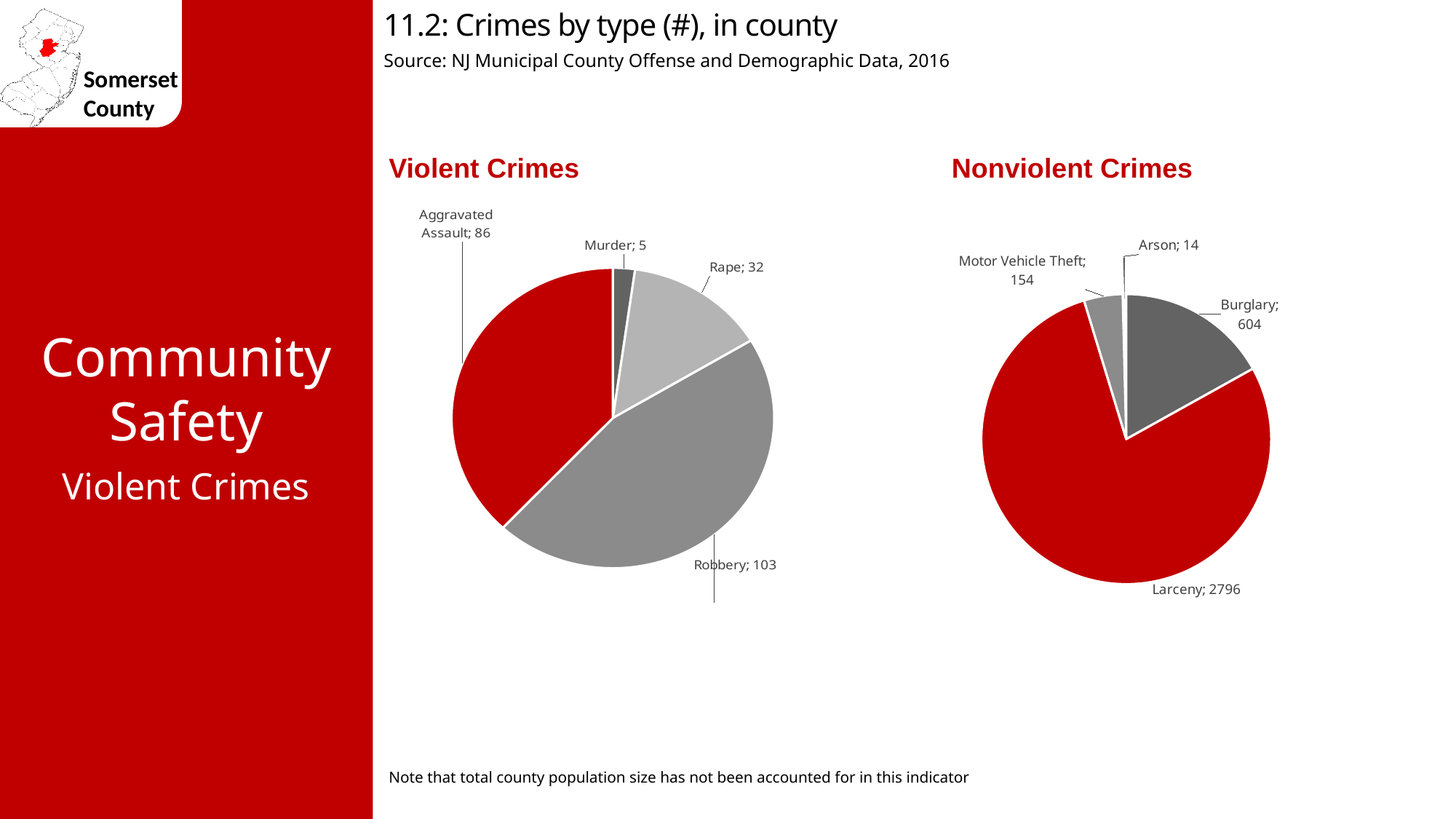
In the Nonviolent Crimes chart, what is the value for Motor Vehicle Theft? 154 In the Nonviolent Crimes chart, what share of the total does Larceny represent, to the nearest whole percent? 78% In the Nonviolent Crimes chart, what is the value for Burglary? 604 In the Violent Crimes chart, what is the value for Murder? 5 In the Violent Crimes chart, which crime type has the largest slice? Robbery In the Violent Crimes chart, what is the total of all four slices? 226 What kind of chart is the Violent Crimes chart? Pie chart In the Violent Crimes chart, how many robberies are shown? 103 How many crime types are shown in the Nonviolent Crimes chart? 4 In the Nonviolent Crimes chart, which crime type has the smallest slice? Arson In the Violent Crimes chart, what is the difference between Robbery and Aggravated Assault? 17 In the Nonviolent Crimes chart, which is larger, Burglary or Motor Vehicle Theft? Burglary